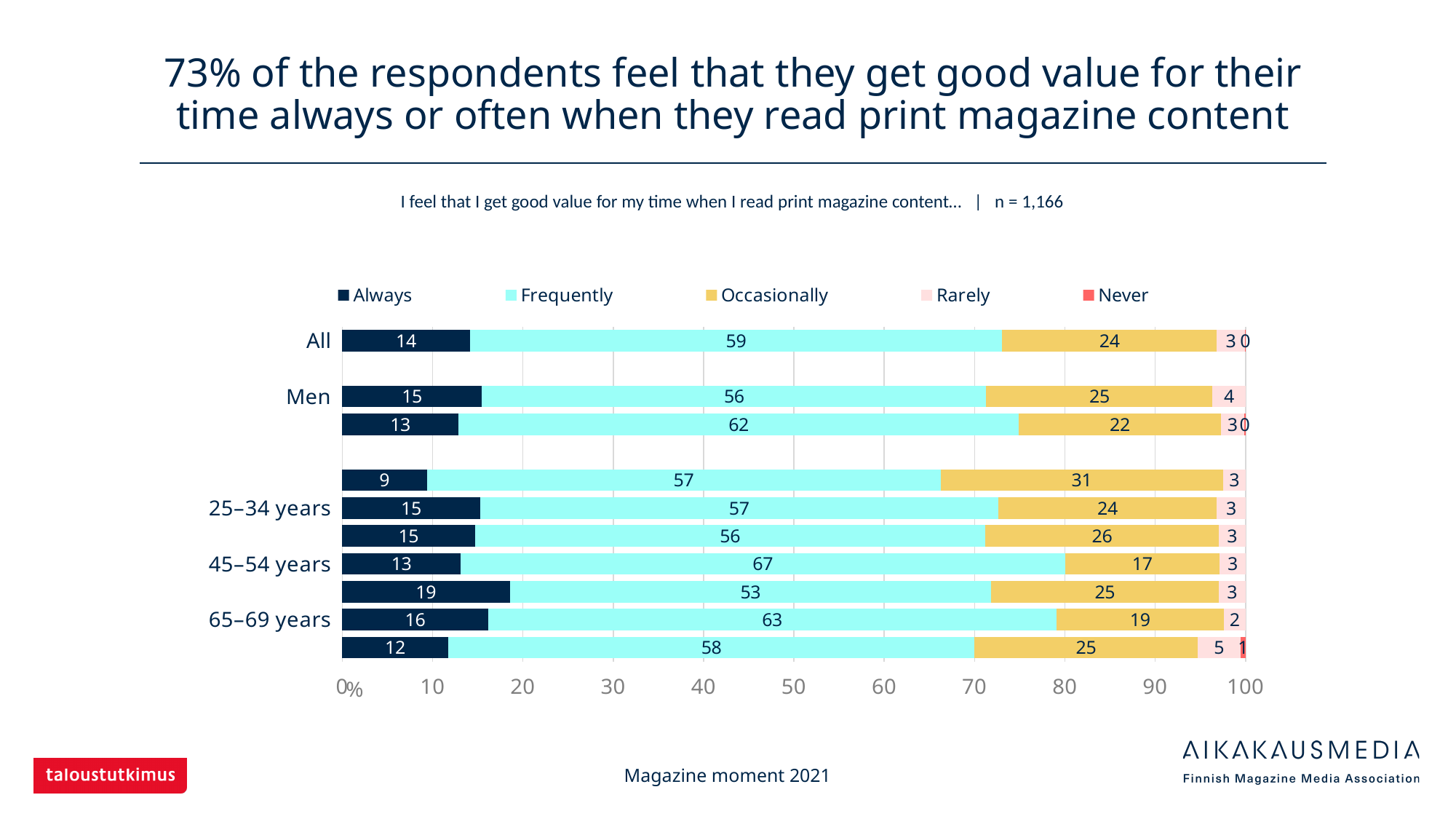
What is the value for Always in the All row? 14 How many series does the legend list? 5 What colour represents Always in the legend? Dark navy blue What is the difference between the Frequently value for 45–54 years and the Frequently value for Men? 11 What kind of chart is shown on the slide? Stacked bar chart Which of the labelled groups has the highest Frequently value? 45–54 years Which has the larger Always value, 65–69 years or 25–34 years? 65–69 years What is the value for Frequently in the Men row? 56 What is the combined total of Always and Frequently in the All row? 73 What sample size (n) is stated above the chart? n = 1,166 What is the value for Occasionally in the 45–54 years row? 17 What is the value for Rarely in the 65–69 years row? 2